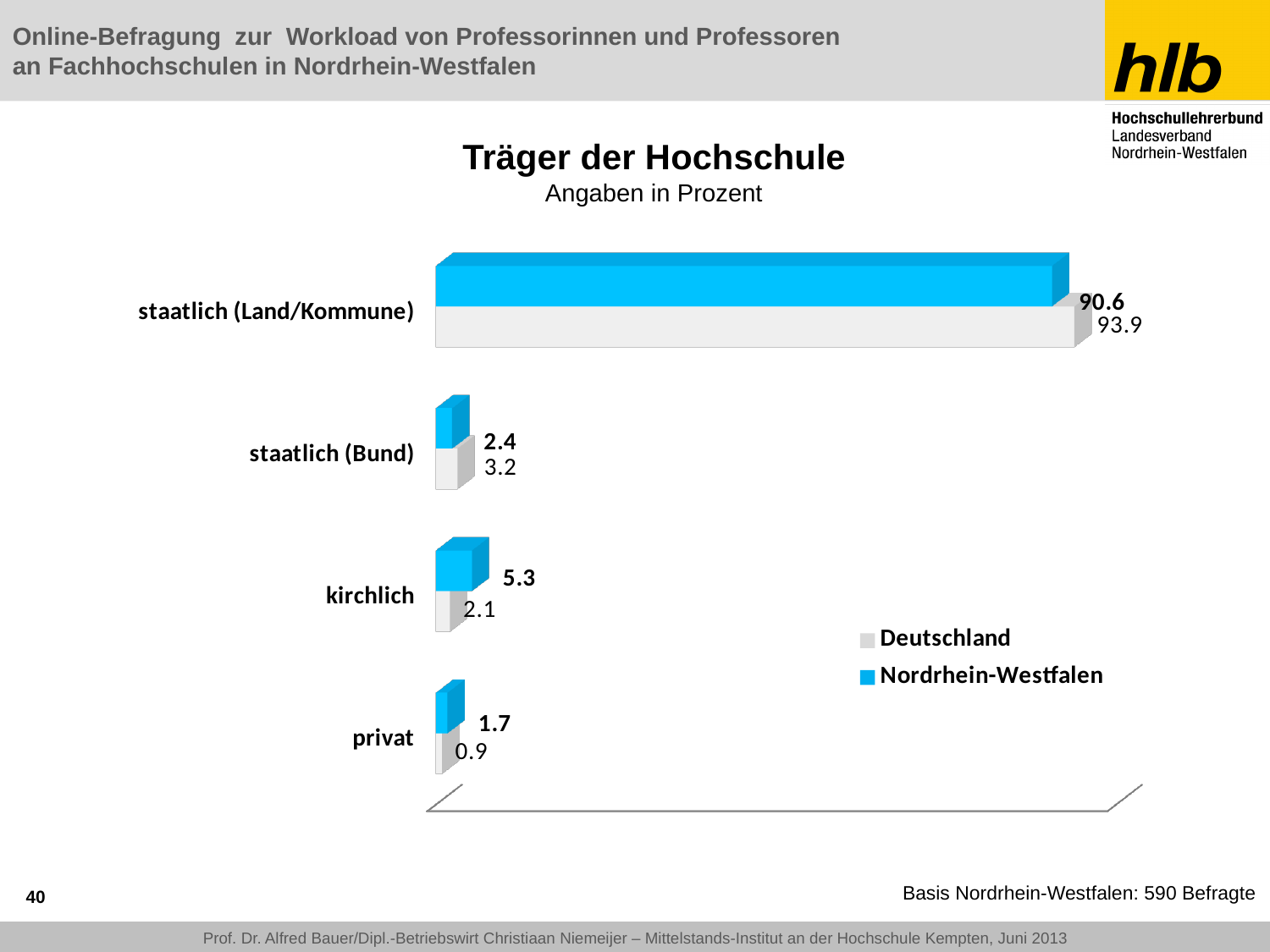
What is the value for Nordrhein-Westfalen in the category kirchlich? 5.3 What is the difference between the Deutschland and Nordrhein-Westfalen values for staatlich (Land/Kommune)? 3.3 How many series does the legend list? 2 How many categories are shown in the chart? 4 What is the value for Nordrhein-Westfalen in the category staatlich (Land/Kommune)? 90.6 What is the difference between the Nordrhein-Westfalen and Deutschland values for kirchlich? 3.2 For the category staatlich (Bund), which series has the larger value, Deutschland or Nordrhein-Westfalen? Deutschland What is the value for Deutschland in the category privat? 0.9 What is the value for Deutschland in the category staatlich (Land/Kommune)? 93.9 Which category has the lowest value for Deutschland? privat What kind of chart is shown on the slide? Bar chart Which category has the highest value for Nordrhein-Westfalen? staatlich (Land/Kommune)